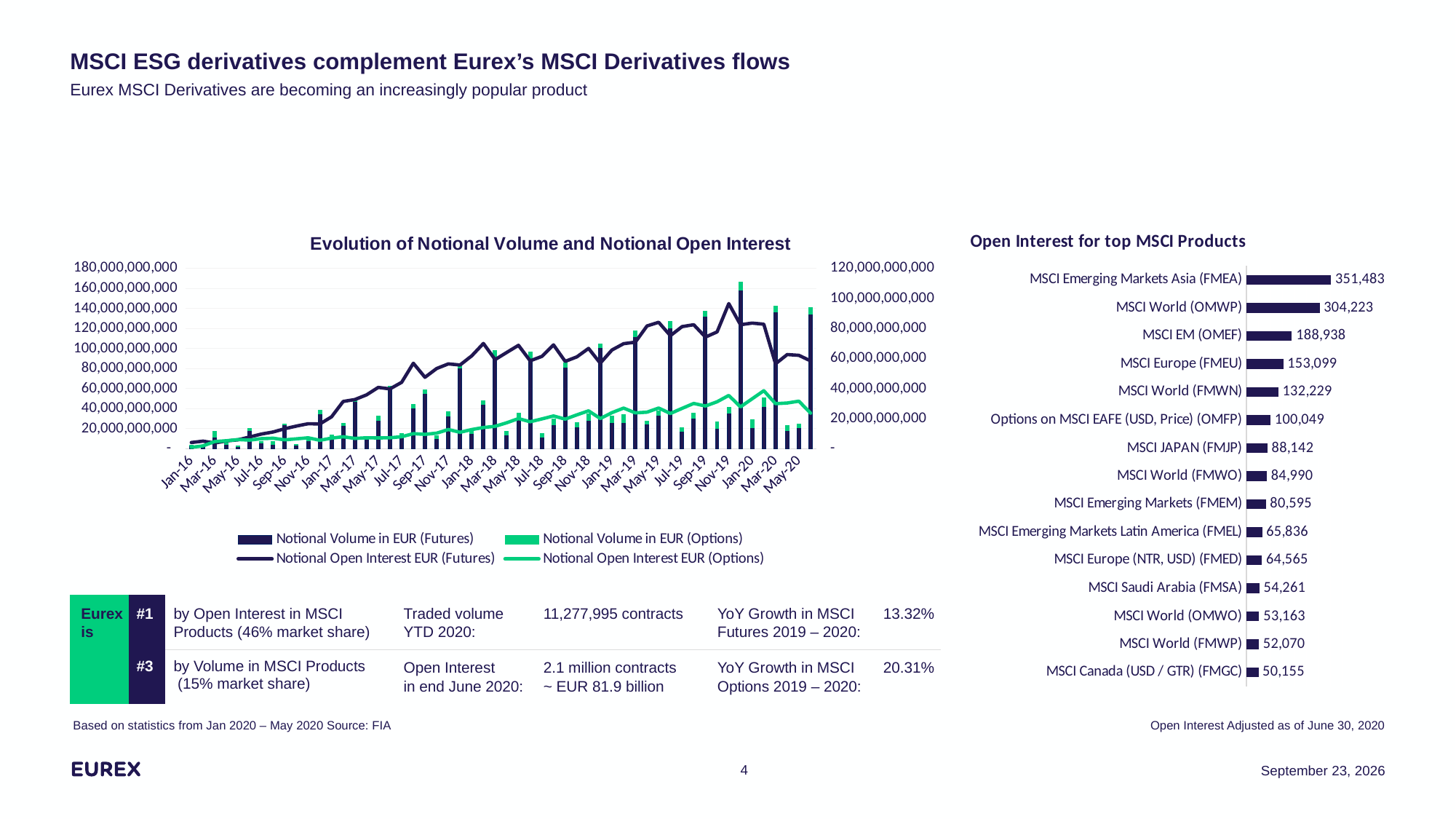
In the 'Open Interest for top MSCI Products' chart, which product has the highest open interest? MSCI Emerging Markets Asia (FMEA) In the 'Open Interest for top MSCI Products' chart, which is larger: MSCI JAPAN (FMJP) or MSCI World (FMWO)? MSCI JAPAN (FMJP) In the 'Open Interest for top MSCI Products' chart, which product has the lowest open interest? MSCI Canada (USD / GTR) (FMGC) In the 'Open Interest for top MSCI Products' chart, what is the value for MSCI Europe (FMEU)? 153,099 In the 'Open Interest for top MSCI Products' chart, what is the value for MSCI Saudi Arabia (FMSA)? 54,261 How many series does the legend of the 'Evolution of Notional Volume and Notional Open Interest' chart list? 4 In the 'Evolution of Notional Volume and Notional Open Interest' chart, does the Notional Open Interest EUR (Futures) line generally rise or fall from Jan-16 to Jan-20? Rise In the 'Open Interest for top MSCI Products' chart, what is the difference between MSCI Emerging Markets Asia (FMEA) and MSCI World (OMWP)? 47,260 In the 'Open Interest for top MSCI Products' chart, what is the open interest for MSCI Emerging Markets Asia (FMEA)? 351,483 In the 'Open Interest for top MSCI Products' chart, what is the difference between MSCI EM (OMEF) and MSCI Europe (FMEU)? 35,839 What kind of chart is 'Open Interest for top MSCI Products'? Bar chart How many products are shown in the 'Open Interest for top MSCI Products' chart? 15